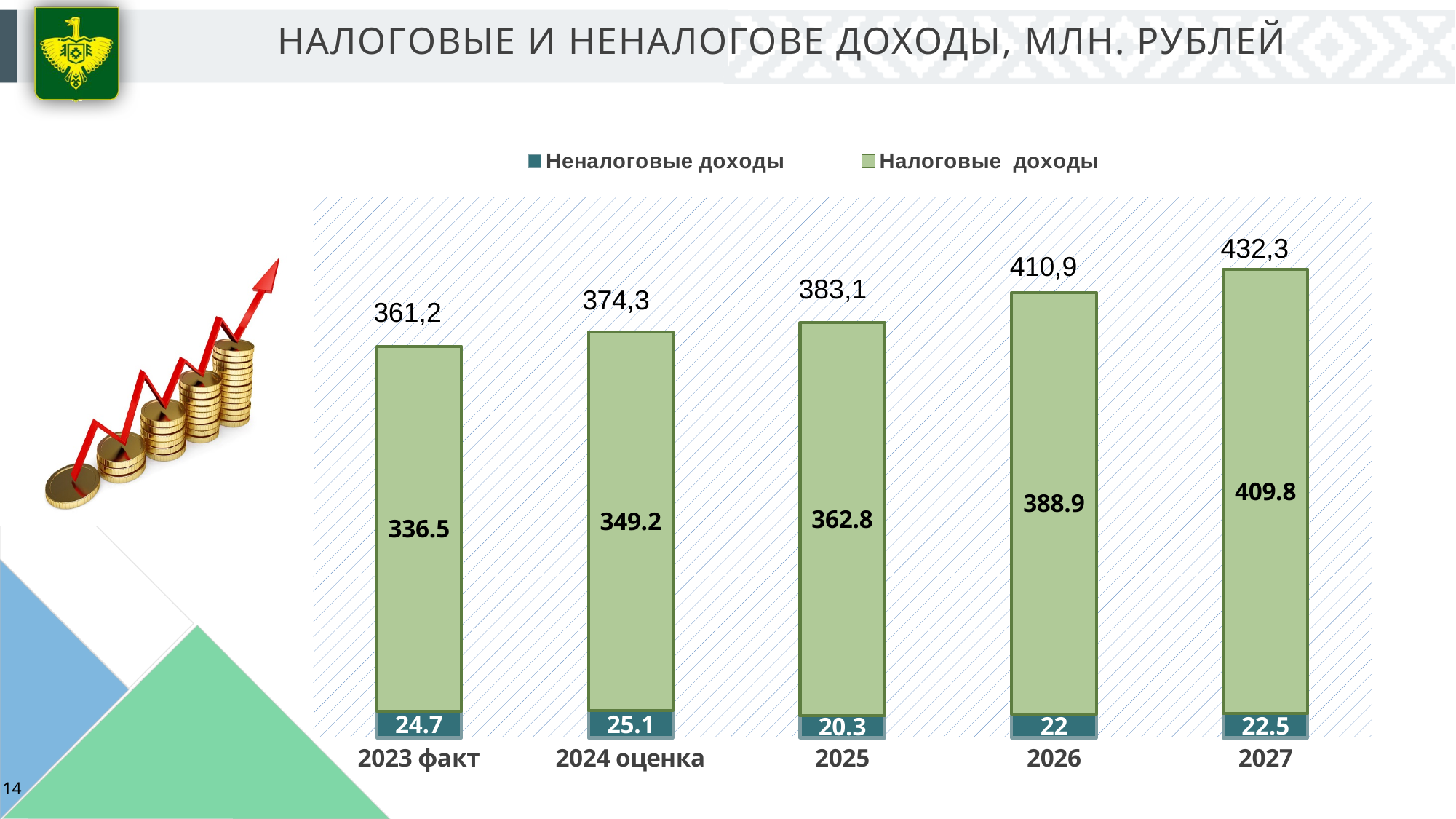
What is the value of Неналоговые доходы for 2024 оценка? 25.1 What is the total shown above the bar for 2027? 432,3 What is the value of Налоговые доходы for 2025? 362.8 Which category has the lowest value for Неналоговые доходы? 2025 What type of chart is shown on the slide? Stacked bar chart What is the difference between Налоговые доходы in 2026 and in 2025? 26.1 How many categories are shown along the x axis? 5 Do the total values rise or fall from 2023 факт to 2027? Rise How many series does the legend list? 2 What is the title of the chart on the slide? НАЛОГОВЫЕ И НЕНАЛОГОВЕ ДОХОДЫ, МЛН. РУБЛЕЙ Which is larger: Неналоговые доходы in 2023 факт or in 2027? 2023 факт Which category has the highest value for Налоговые доходы? 2027